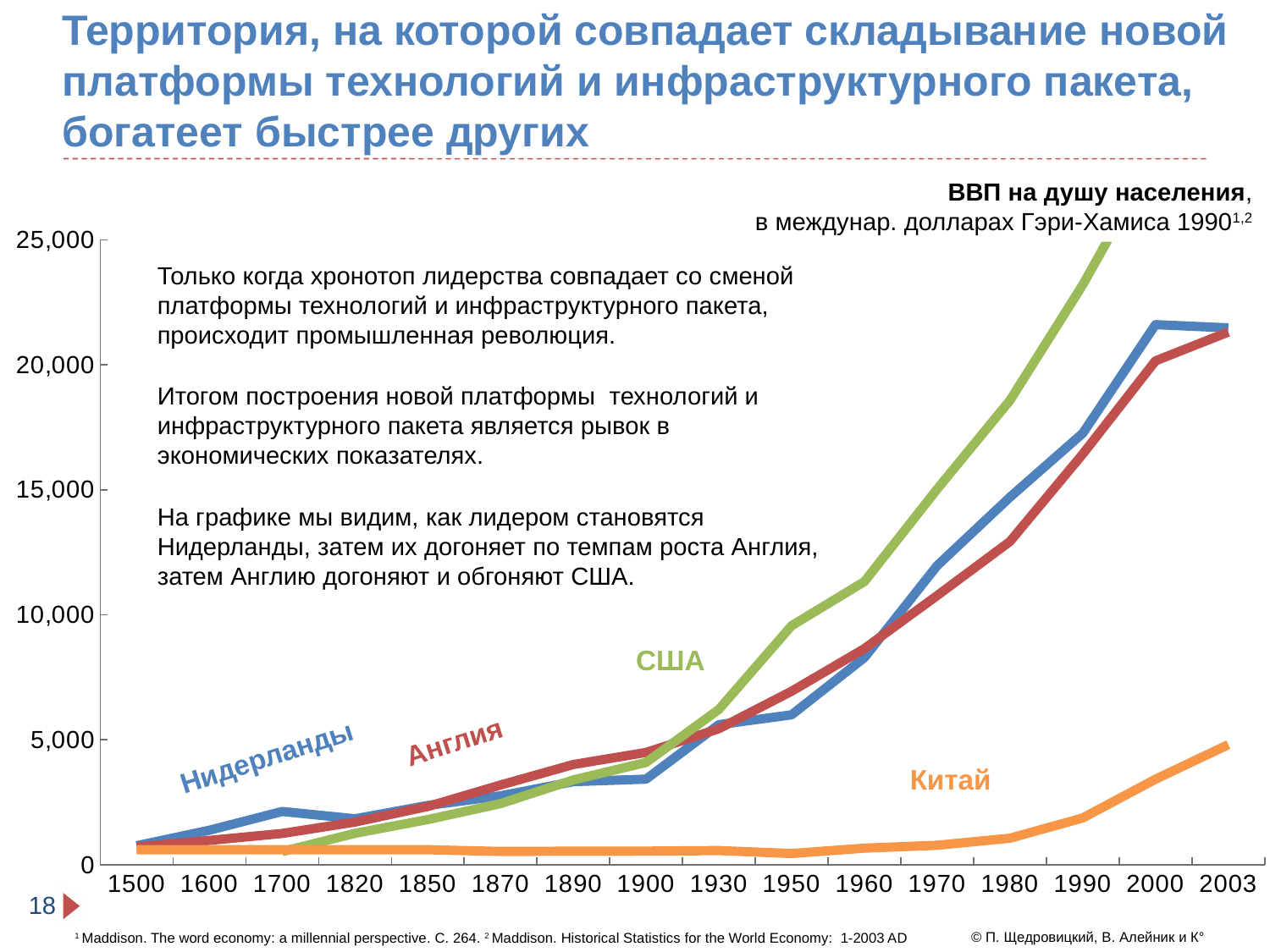
What colour is the line for Китай on the chart? orange How many year points are marked along the x axis of the chart? 16 How many countries (series) are plotted on the chart? 4 Is the value for Китай in 1990 greater or less than 5,000? less Which country has the lowest GDP per capita in 2003 on the chart? Китай Is the value for США in 1990 greater or less than 20,000? greater What kind of chart is shown on the slide? line chart Is the value for Англия in 1980 greater or less than 15,000? less In 1700, which is larger: the value for Нидерланды or the value for Англия? Нидерланды Does the line for Китай rise or fall from 1980 to 2003? rises Which country has the highest GDP per capita in 1990 on the chart? США